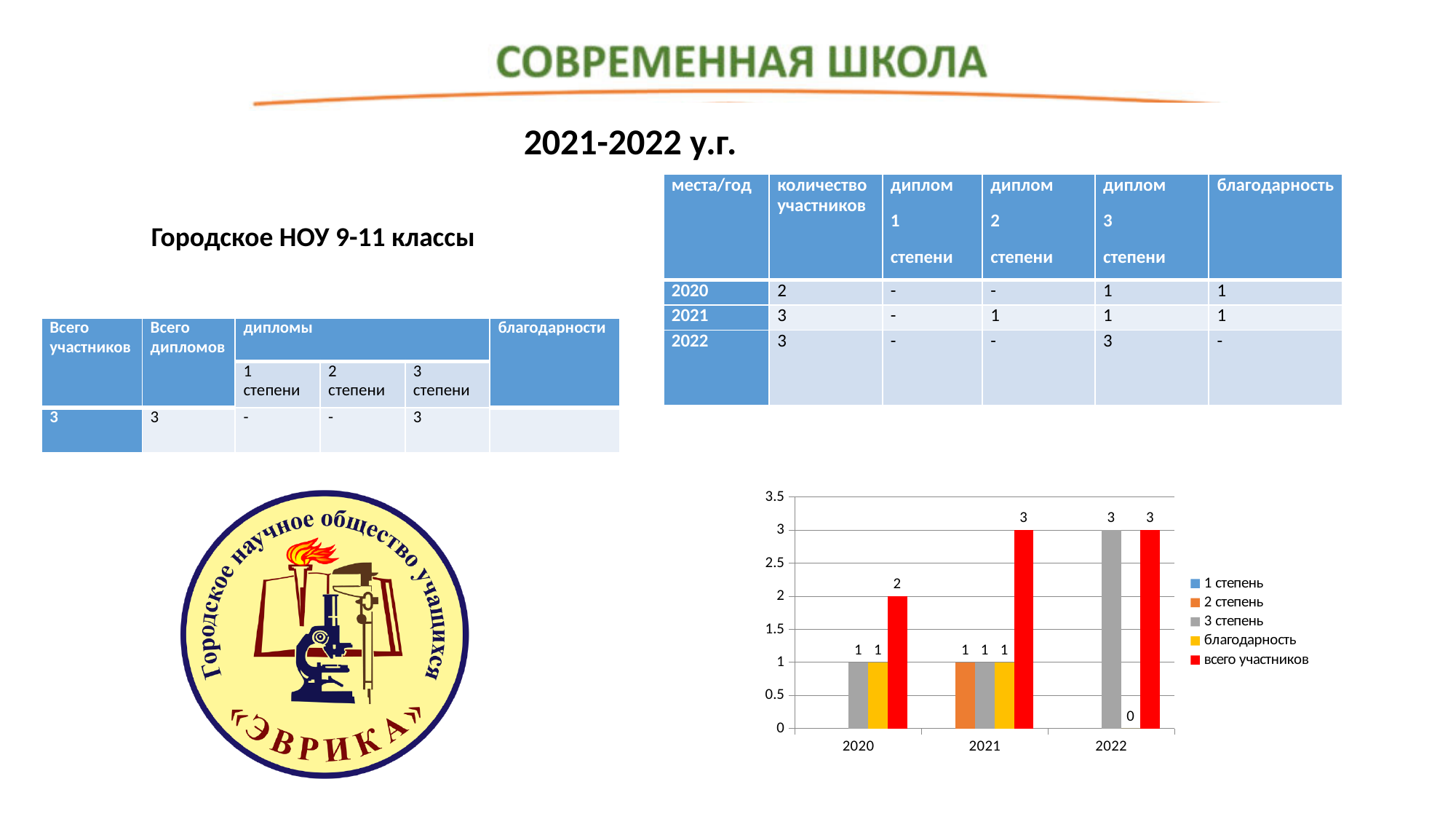
What is the value of 'всего участников' for 2021 in the chart? 3 Which year has the lowest value for 'всего участников' in the chart? 2020 How many year categories are shown on the x axis of the chart? 3 What kind of chart is shown on the slide? bar chart Which series in the chart legend is shown in red? всего участников What is the value of '3 степень' for 2022 in the chart? 3 What is the difference between 'всего участников' for 2021 and for 2020 in the chart? 1 What is the value of '2 степень' for 2021 in the chart? 1 What is the value of 'всего участников' for 2020 in the chart? 2 Which is larger in the chart: '3 степень' for 2022 or '3 степень' for 2021? 3 степень for 2022 What is the value of 'благодарность' for 2022 in the chart? 0 How many series does the chart legend list? 5